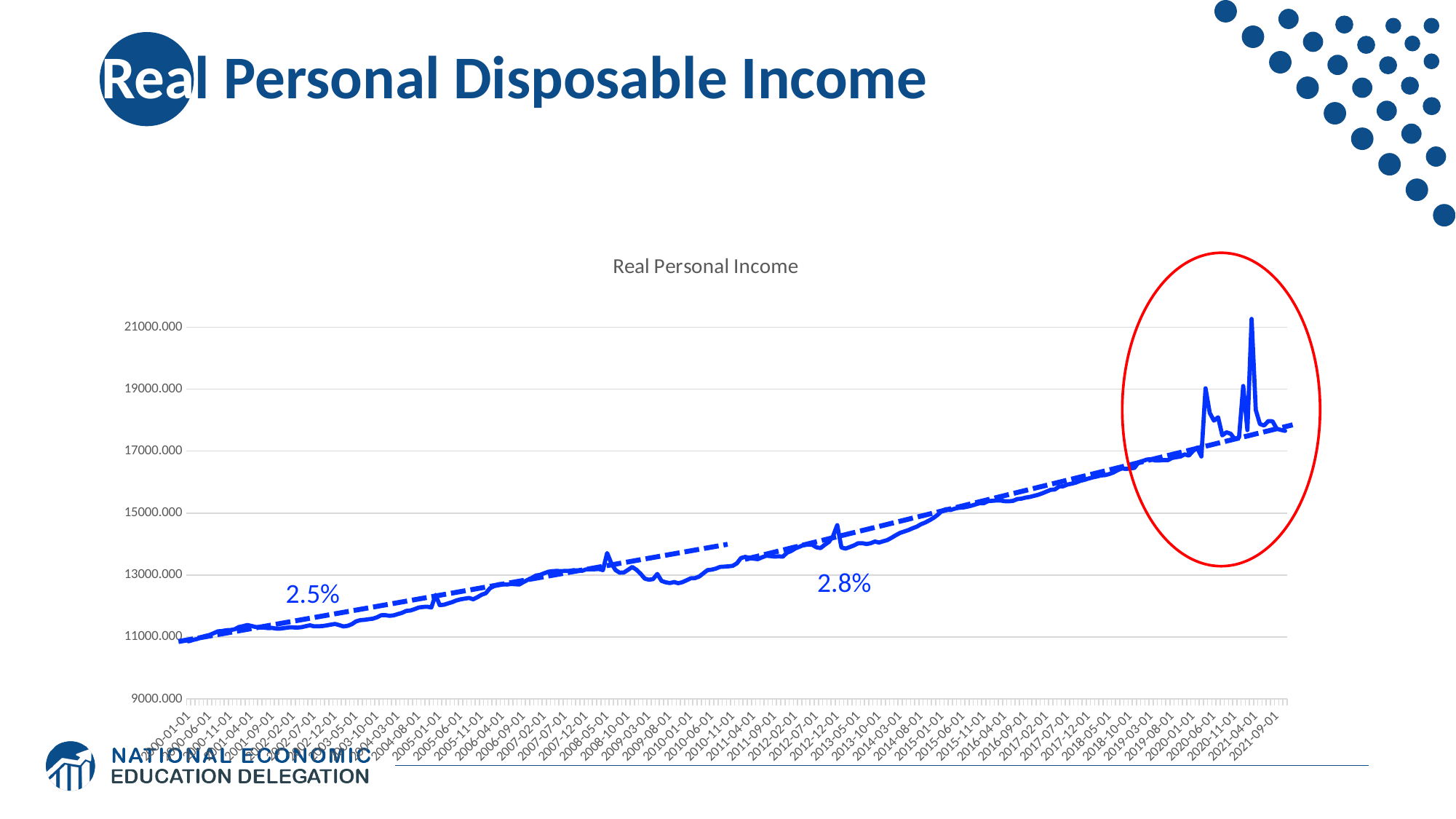
What growth rate is annotated next to the left dashed trend line? 2.5% Is the value of the line at 2021-09-01 greater or less than 15000.000? greater What is the title of the chart? Real Personal Income Is the highest value reached by the line greater or less than 19000.000? greater Is the value of the line around 2010-01-01 greater or less than 15000.000? less What kind of chart is shown on the slide? line chart Which is larger, the value at 2021-09-01 or the value at 2000-01-01? 2021-09-01 In which year does the line reach its highest value? 2021 Do the values of the Real Personal Income line generally rise or fall from 2000 to 2021? rise At which date does the line have its lowest value? 2000-01-01